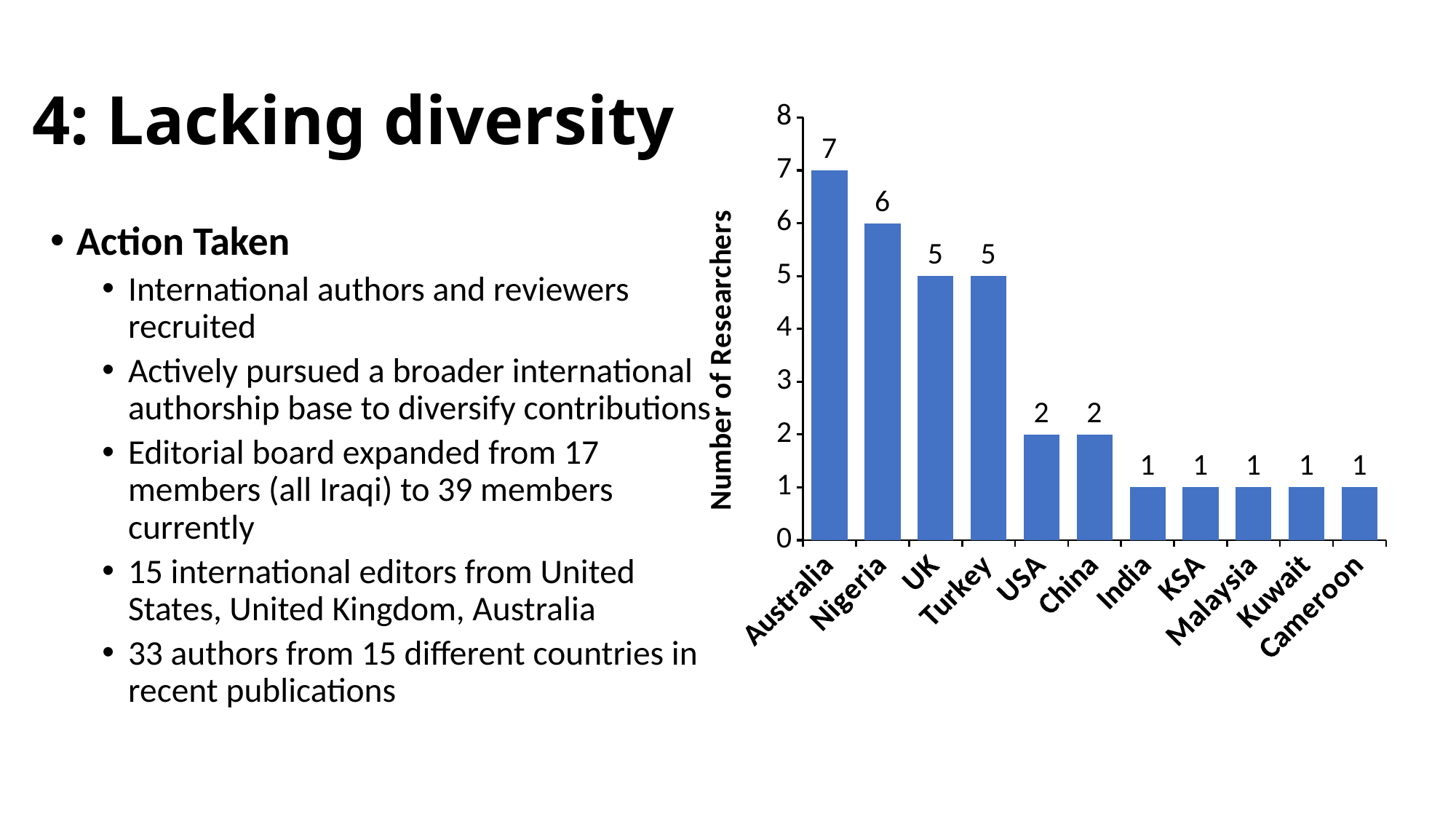
Do the values rise or fall moving from left to right along the x axis? fall What is the number of researchers for Nigeria? 6 What is the difference in number of researchers between Nigeria and China? 4 Is the value for Nigeria greater or less than 4? greater Which has more researchers, Turkey or USA? Turkey What is the difference in number of researchers between Australia and UK? 2 Which country has the highest number of researchers? Australia What is the label of the vertical axis of the chart? Number of Researchers How many countries are shown on the x axis of the chart? 11 What is the number of researchers for Australia? 7 What is the number of researchers for USA? 2 What kind of chart is shown on the slide? bar chart